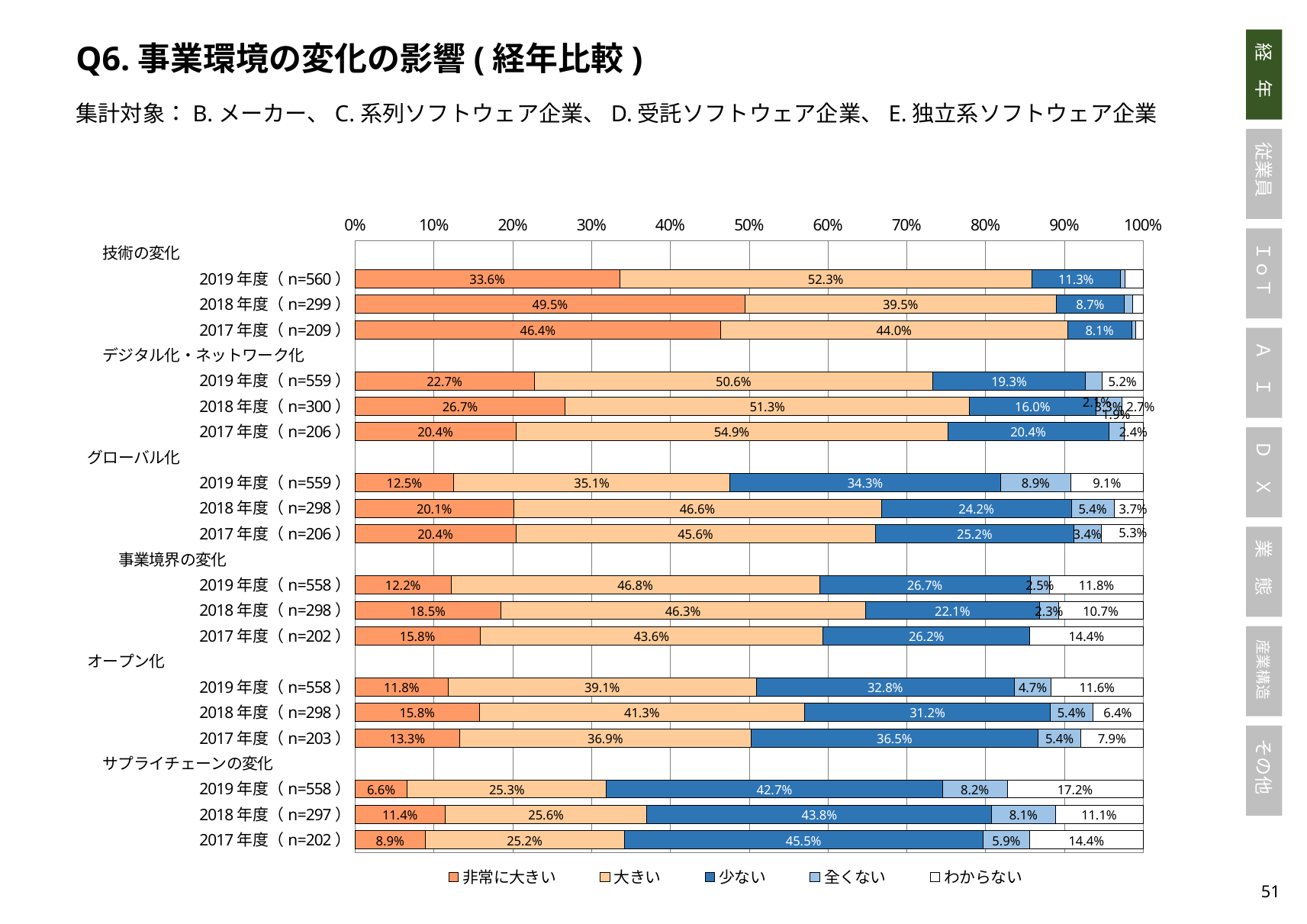
For 事業境界の変化, which year has the larger わからない value, 2019年度 or 2018年度? 2019年度 (11.8%) What is the 非常に大きい value for 技術の変化 in 2019年度 (n=560)? 33.6% What is the 少ない value for サプライチェーンの変化 in 2019年度 (n=558)? 42.7% What kind of chart is shown on the slide? Stacked bar chart For サプライチェーンの変化, does the 少ない value rise or fall from 2017年度 to 2019年度? Falls (45.5% to 43.8% to 42.7%) Which bar has the lowest 非常に大きい value? サプライチェーンの変化 2019年度 (n=558), 6.6% For 技術の変化, how much higher is the 非常に大きい value in 2018年度 than in 2019年度? 15.9 percentage points How many bars (year rows) are plotted in the chart? 18 How many series does the legend list? 5 What is the わからない value for グローバル化 in 2019年度 (n=559)? 9.1% Which bar has the highest 非常に大きい value? 技術の変化 2018年度 (n=299), 49.5% What is the 大きい value for デジタル化・ネットワーク化 in 2017年度 (n=206)? 54.9%